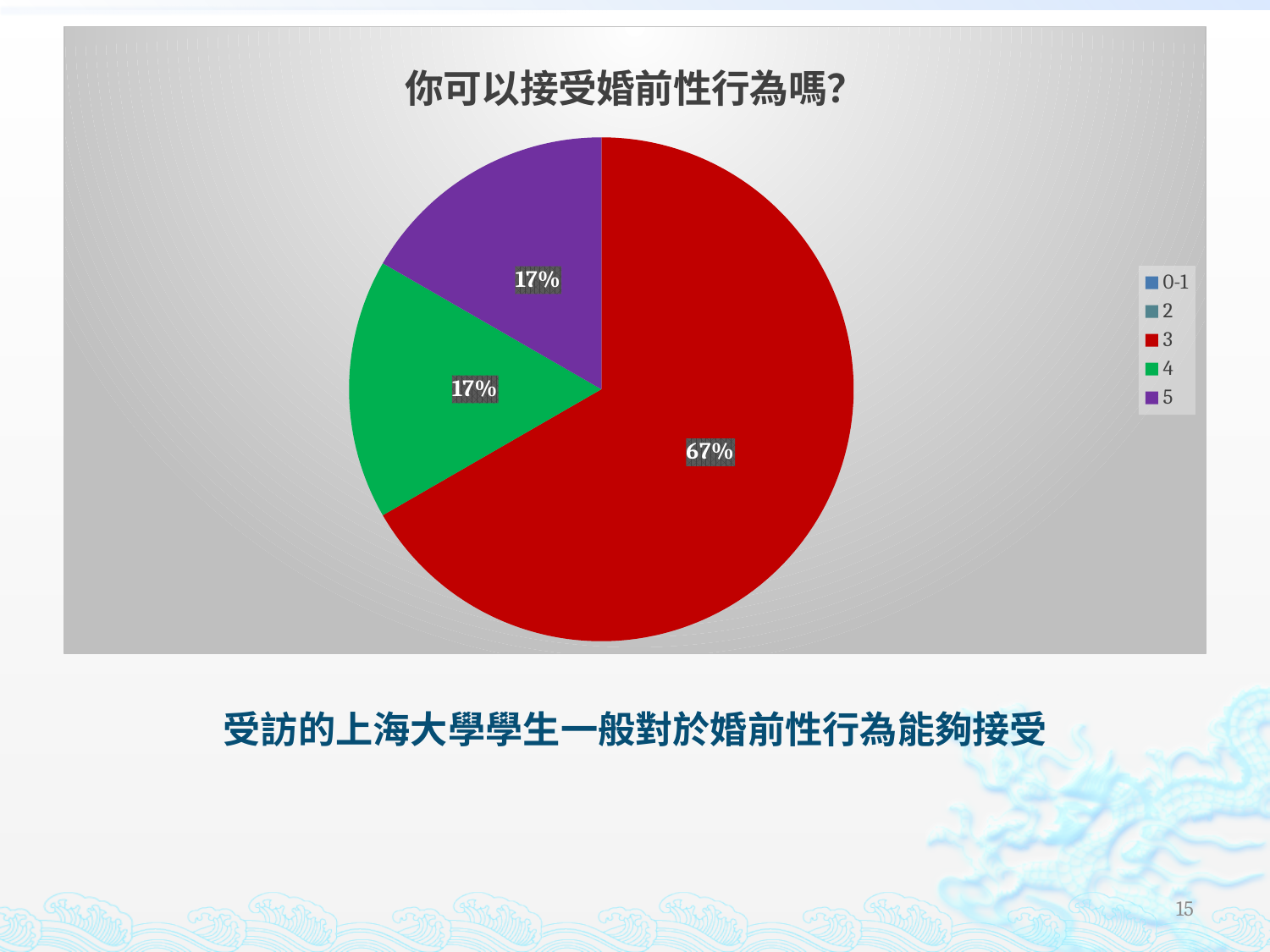
Which is larger, the slice for category 3 or the slice for category 5? 3 Is the share for category 3 greater or less than 50%? greater Which category has the largest slice of the pie? 3 What share of the pie does category 4 take? 17% What is the title of the chart? 你可以接受婚前性行為嗎? What is the difference between the share for category 3 and the share for category 4? 50% What share of the pie does category 5 take? 17% What colour is the slice for category 3? red What kind of chart is shown on the slide? pie chart What share of the pie does category 3 take? 67% What is the combined share of categories 4 and 5? 34% How many entries does the legend list? 5